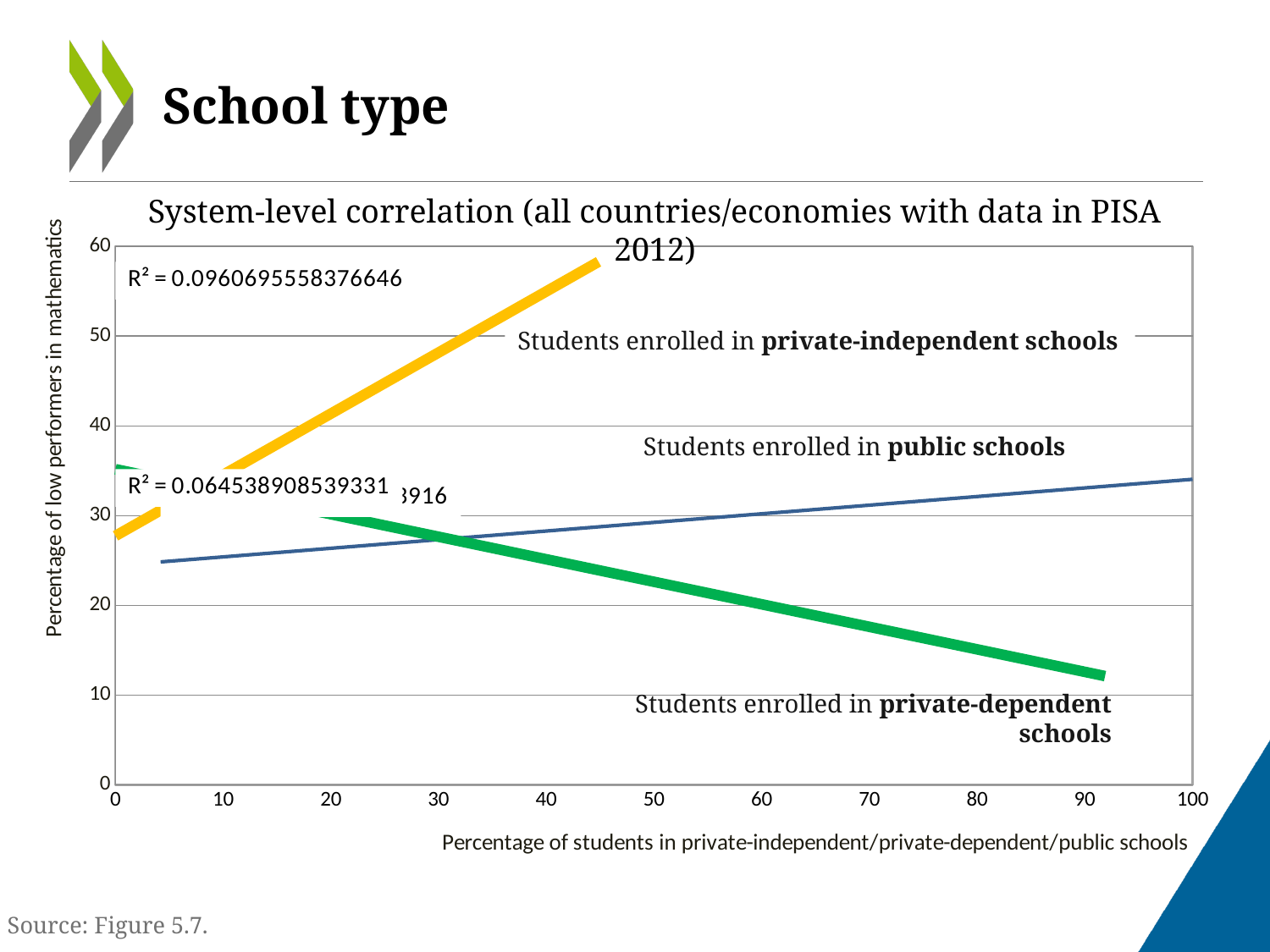
Does the line for students enrolled in private-independent schools rise or fall as the percentage of students increases? rise How many school-type series are plotted on the chart? 3 At 60 on the x axis, which line is higher: public schools or private-dependent schools? public schools Does the line for students enrolled in public schools rise or fall along the x axis? rise Is the value of the public schools line at 100 on the x axis greater or less than 30? greater What kind of chart is shown on the slide? line chart What R² value is printed at the top left of the chart? 0.0960695558376646 What is the title of the chart? System-level correlation (all countries/economies with data in PISA 2012) Does the line for students enrolled in private-dependent schools rise or fall along the x axis? fall What is the label of the vertical axis? Percentage of low performers in mathematics Is the value of the private-independent schools line at 40 on the x axis greater or less than 50? greater Is the value of the private-dependent schools line at 90 on the x axis greater or less than 20? less